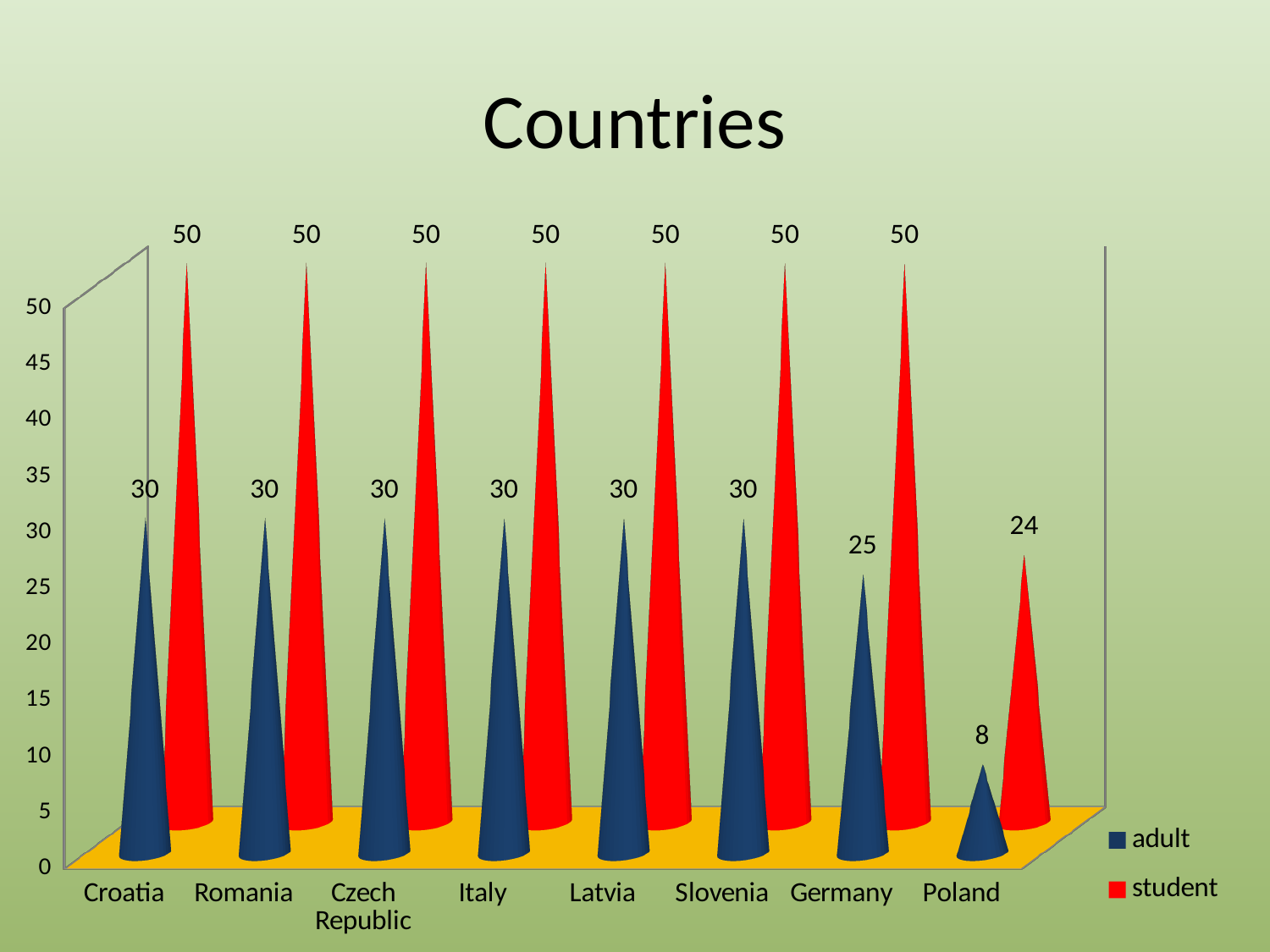
Which country has the lowest adult value? Poland What is the student value for Poland? 24 How many series does the legend list? 2 What is the difference between the student and adult values for Poland? 16 What is the difference between the student and adult values for Germany? 25 What is the student value for Croatia? 50 Which country has the lowest student value? Poland How many countries are shown on the x axis? 8 What is the adult value for Germany? 25 Which is larger for Italy, the adult value or the student value? student What is the adult value for Poland? 8 What is the title of the chart? Countries